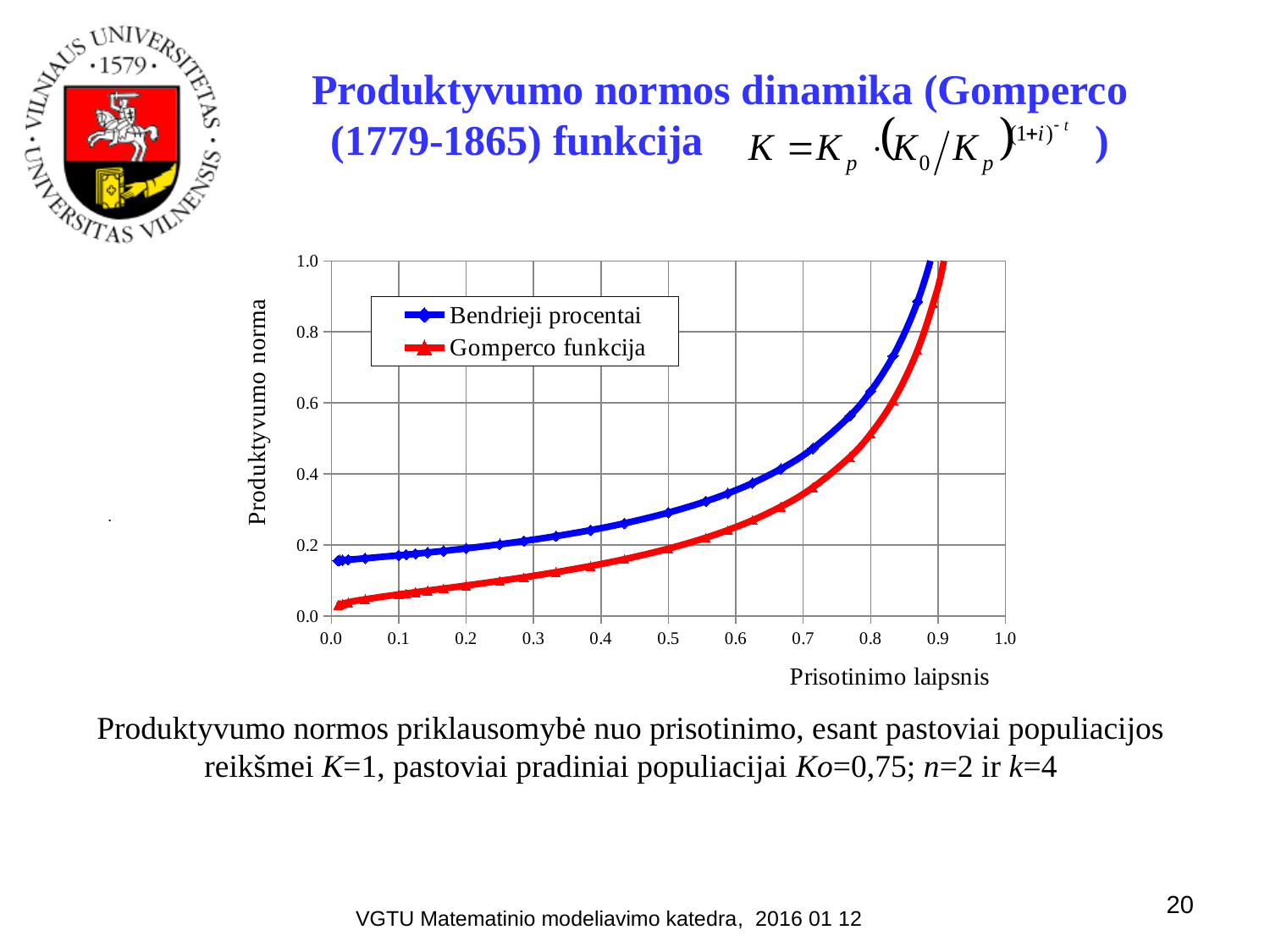
What is the title of the chart's x axis? Prisotinimo laipsnis What are the two series named in the chart legend? Bendrieji procentai and Gomperco funkcija Do the values of the Gomperco funkcija series rise or fall as Prisotinimo laipsnis increases? rise What kind of chart is shown on the slide? line chart Which series lies above the other across the plotted range? Bendrieji procentai Is the value of Gomperco funkcija at Prisotinimo laipsnis 0.0 greater or less than 0.2? less Do the values of the Bendrieji procentai series rise or fall along the x axis? rise How many series does the chart legend list? 2 At Prisotinimo laipsnis 0.5, which series has the larger value, Bendrieji procentai or Gomperco funkcija? Bendrieji procentai Is the value of Bendrieji procentai at Prisotinimo laipsnis 0.0 greater or less than 0.2? less Is the value of Gomperco funkcija at Prisotinimo laipsnis 0.8 greater or less than 0.4? greater